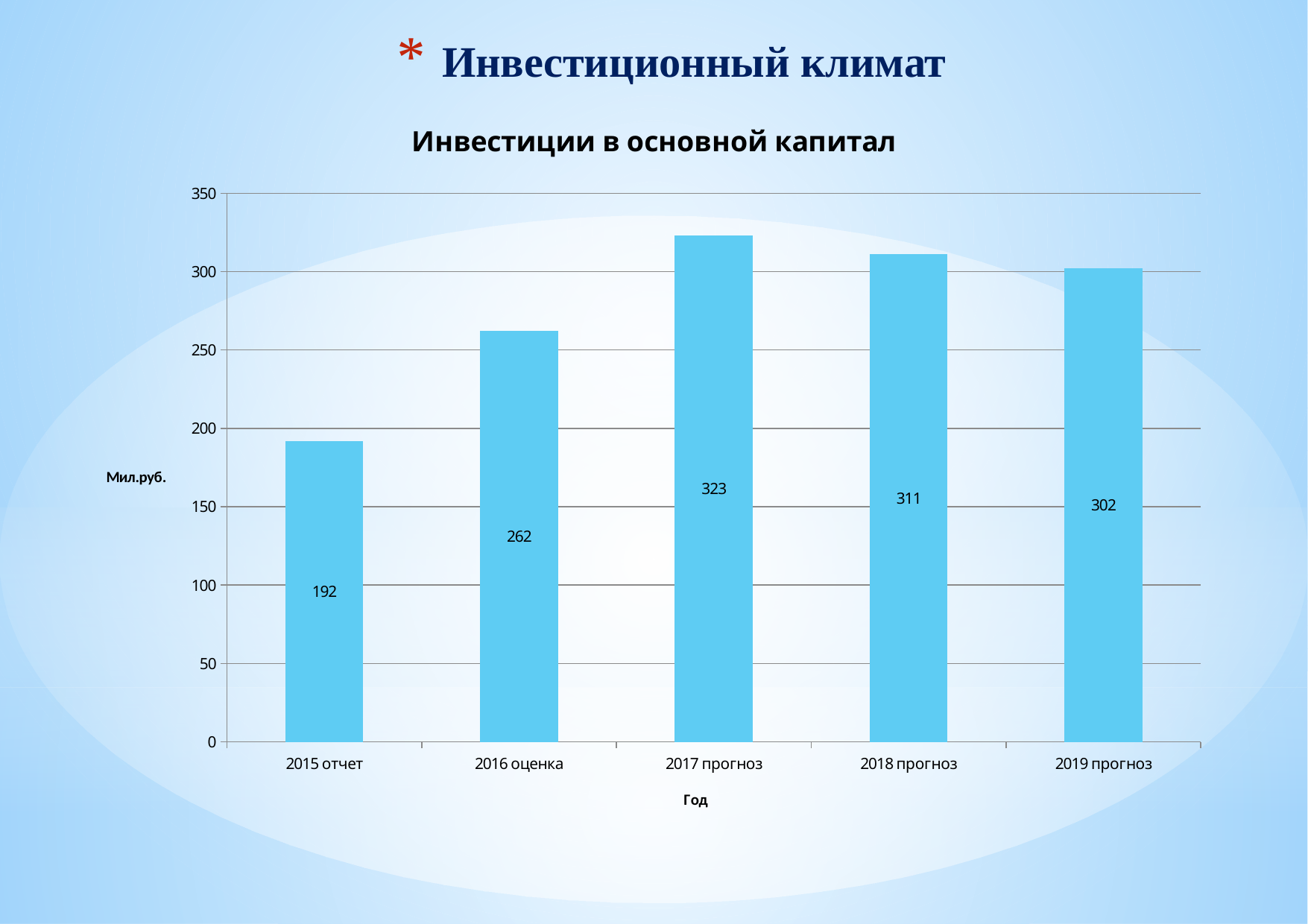
How many categories are shown on the x axis? 5 Which category has the lowest value? 2015 отчет What is the value for 2015 отчет? 192 Which category has the highest value? 2017 прогноз Is the value for 2016 оценка greater or less than 250? greater What is the value for 2017 прогноз? 323 What kind of chart is shown on the slide? bar chart What is the difference between the values for 2018 прогноз and 2019 прогноз? 9 What is the value for 2019 прогноз? 302 Which is larger, the value for 2016 оценка or the value for 2018 прогноз? 2018 прогноз What is the title of the chart? Инвестиции в основной капитал What is the difference between the values for 2017 прогноз and 2015 отчет? 131